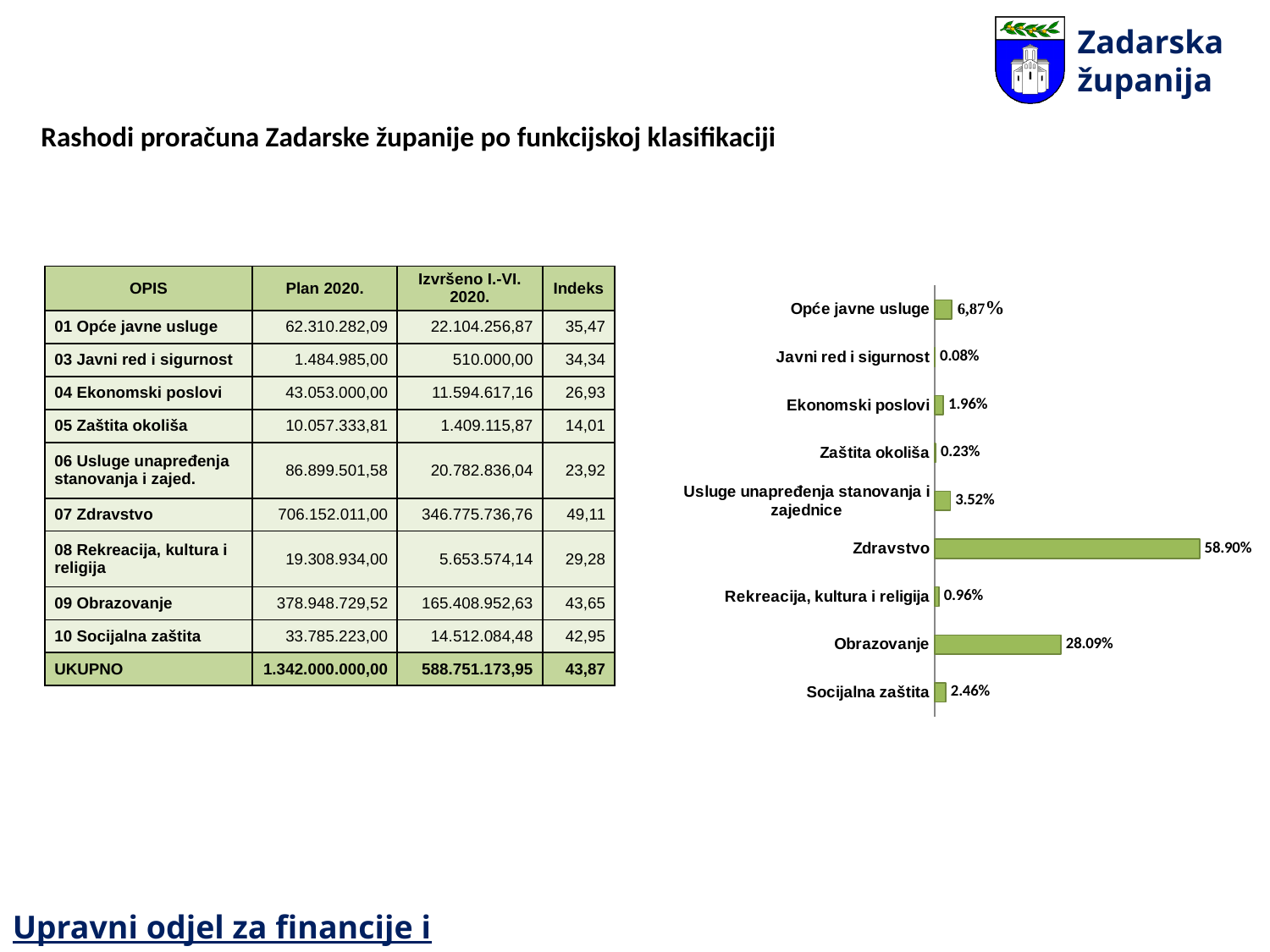
What is the value shown for Socijalna zaštita in the bar chart? 2.46% What is the value shown for Usluge unapređenja stanovanja i zajednice in the bar chart? 3.52% Which category has the highest value in the bar chart? Zdravstvo What is the value shown for Zdravstvo in the bar chart? 58.90% How many categories are shown in the bar chart? 9 In the bar chart, what is the difference between the values for Zdravstvo and Obrazovanje? 30.81% What is the value shown for Opće javne usluge in the bar chart? 6,87% What type of chart is shown on the slide? Bar chart What is the value shown for Zaštita okoliša in the bar chart? 0.23% Which category has the lowest value in the bar chart? Javni red i sigurnost What is the value shown for Obrazovanje in the bar chart? 28.09% In the bar chart, which is larger: Ekonomski poslovi or Socijalna zaštita? Socijalna zaštita